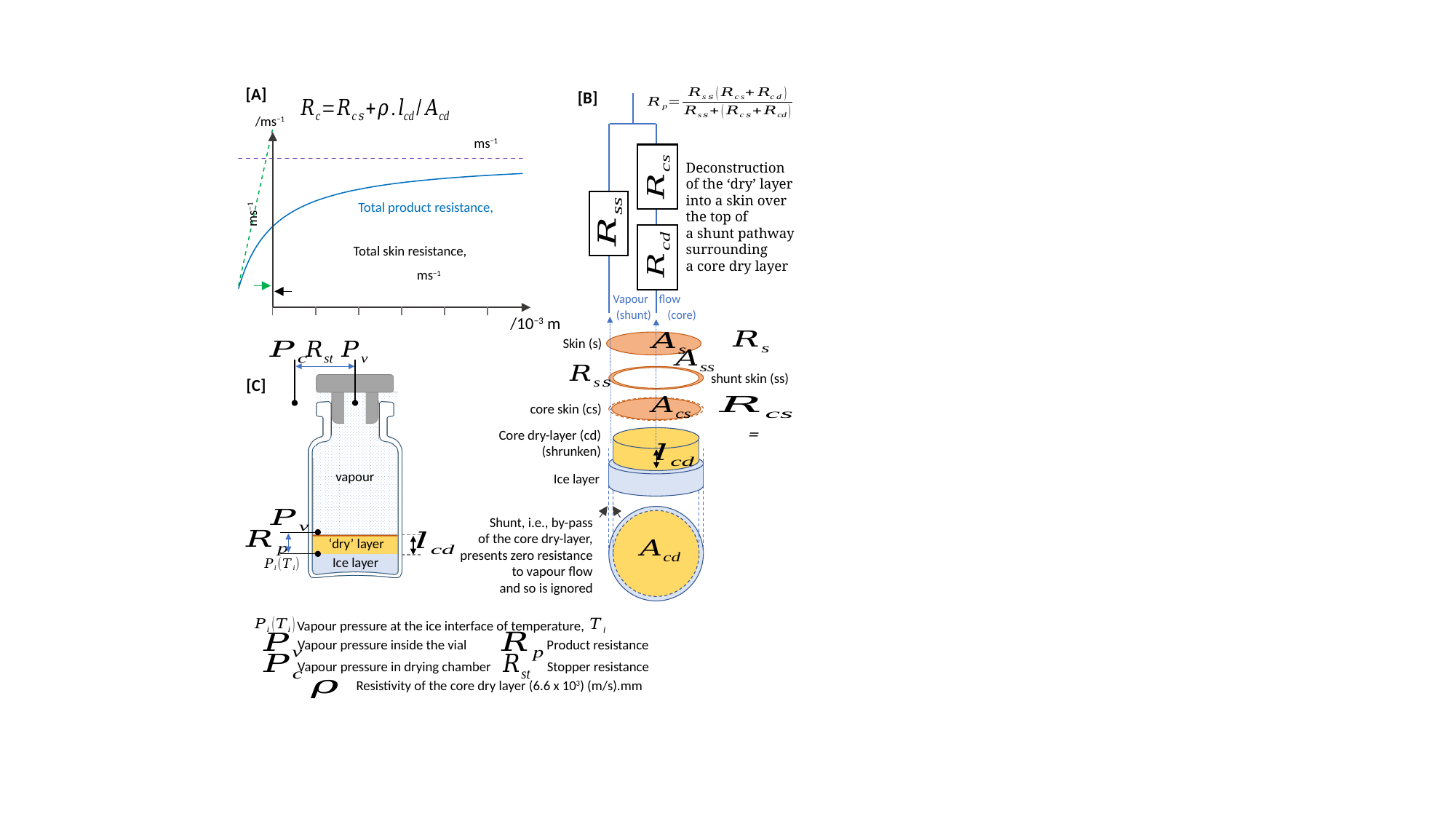
In panel [A], what is the blue curve labelled as? Total product resistance In panel [A], does the blue curve rise or fall as the x-axis value increases? rises In panel [A], what kind of chart is shown? line chart In panel [A], what unit label is shown on the x axis? /10⁻³ m